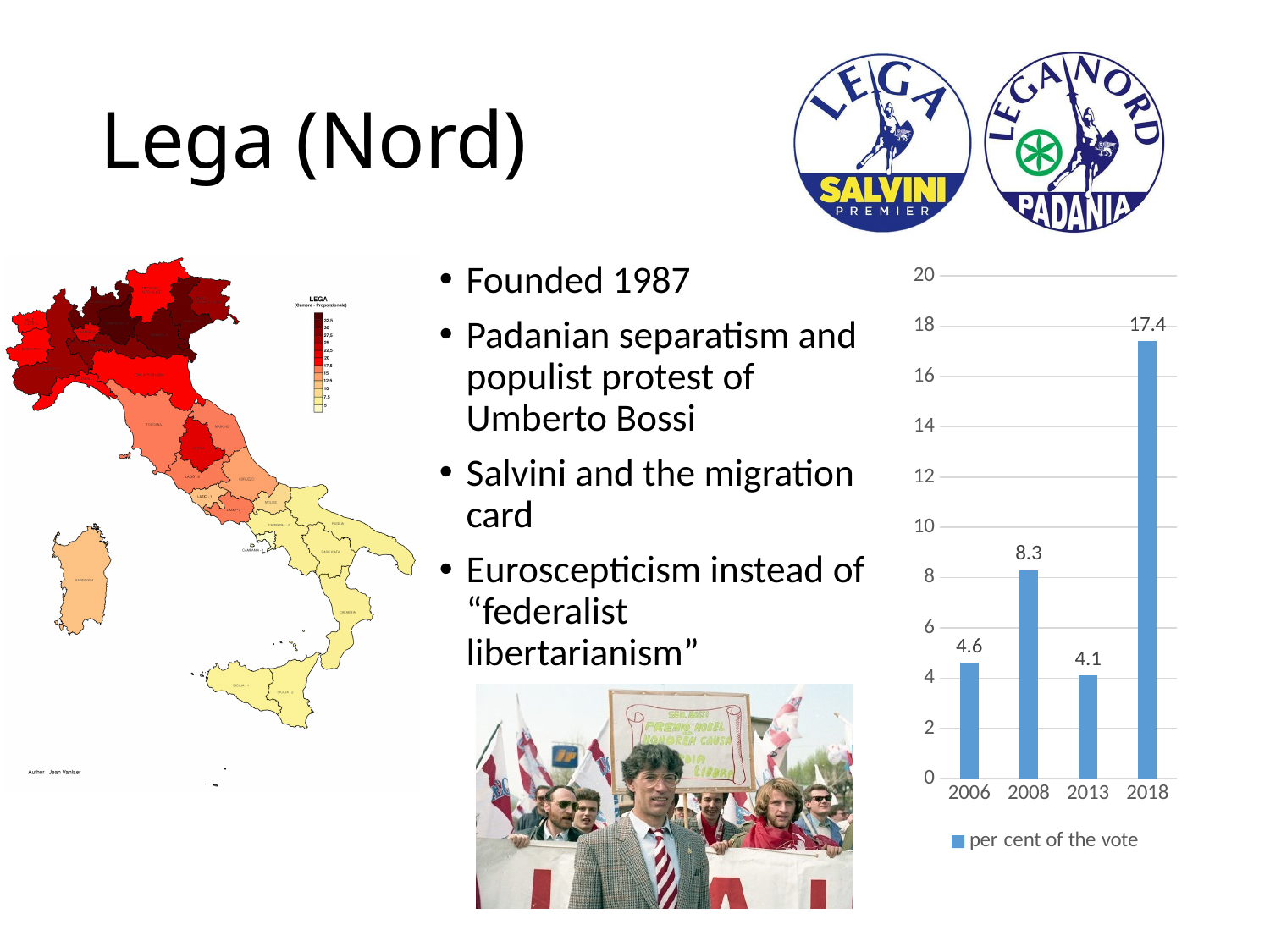
Is the value for 2018 greater or less than 16? greater What is the per cent of the vote shown for 2018 in the bar chart? 17.4 How many years are shown on the x axis of the bar chart? 4 Which year has a larger per cent of the vote, 2006 or 2008? 2008 What is the legend entry of the bar chart? per cent of the vote What kind of chart is used to show the per cent of the vote? bar chart What is the per cent of the vote shown for 2006 in the bar chart? 4.6 Which year has the highest per cent of the vote in the bar chart? 2018 What is the difference between the per cent of the vote in 2018 and in 2008? 9.1 What is the per cent of the vote shown for 2013 in the bar chart? 4.1 Which year has the lowest per cent of the vote in the bar chart? 2013 What is the per cent of the vote shown for 2008 in the bar chart? 8.3